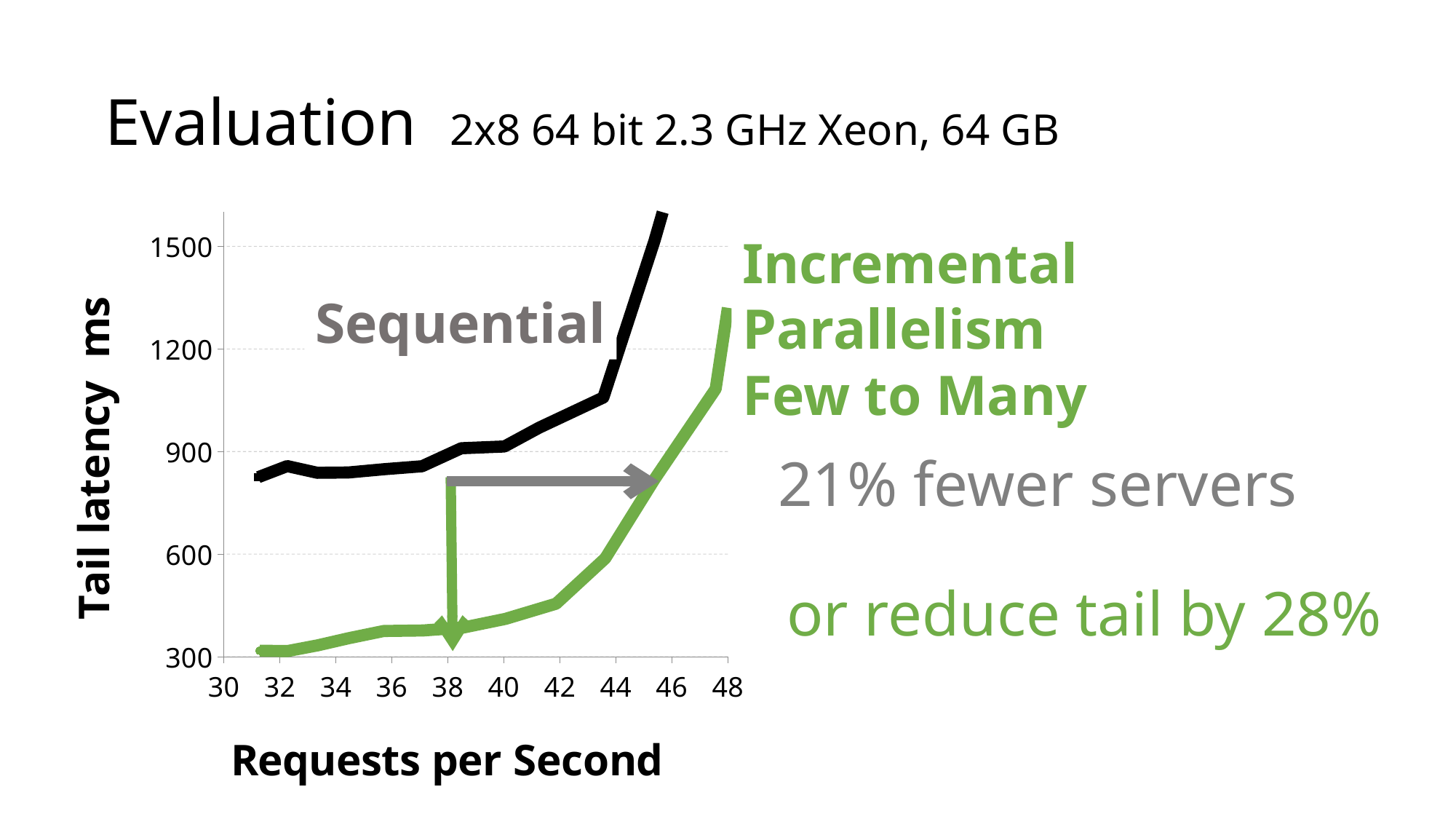
How many lines (series) are plotted on the chart? 2 Does the Sequential tail latency rise or fall as requests per second increase? rise At 40 requests per second, which series has the higher tail latency, Sequential or Incremental Parallelism Few to Many? Sequential What kind of chart is shown on the slide? line chart Does the Incremental Parallelism Few to Many tail latency rise or fall as requests per second increase? rise Is the Sequential tail latency at 44 requests per second greater or less than 900? greater Is the Incremental Parallelism Few to Many tail latency at 42 requests per second greater or less than 600? less Is the Sequential tail latency at 32 requests per second greater or less than 600? greater What is the title of the y axis of the chart? Tail latency ms What is the title of the x axis of the chart? Requests per Second